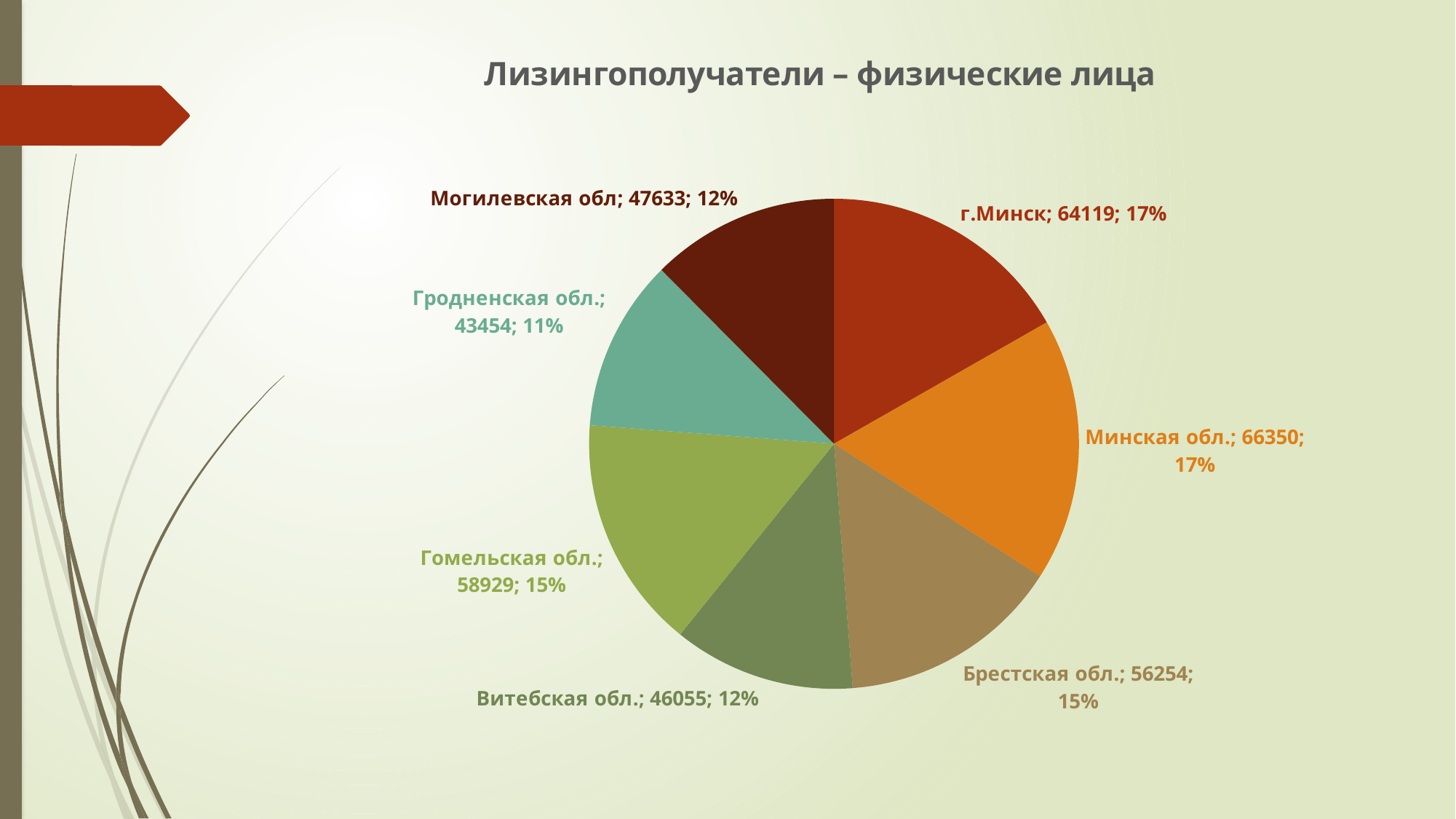
What kind of chart is shown on the slide? Pie chart What is the value for Гродненская обл.? 43454 What is the value for Брестская обл.? 56254 What share of the pie does Гомельская обл. represent? 15% What share of the pie does Могилевская обл represent? 12% What is the difference between the values for Минская обл. and г.Минск? 2231 What is the title of the chart? Лизингополучатели – физические лица Which region has the smallest value? Гродненская обл. Which region has the largest value? Минская обл. Which is larger, the value for Гомельская обл. or the value for Витебская обл.? Гомельская обл. What is the value for г.Минск? 64119 How many slices does the pie chart have? 7